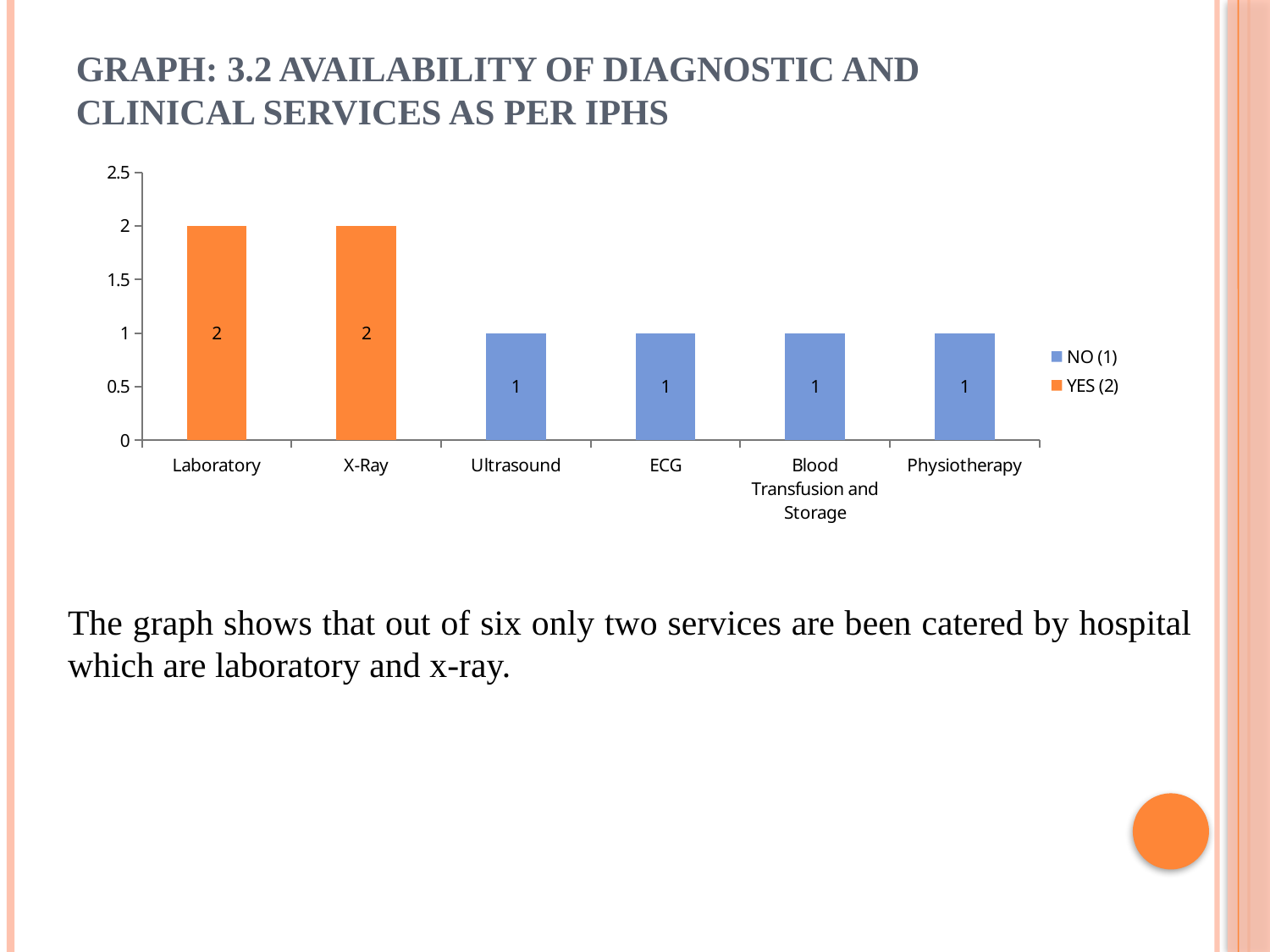
What is the difference between the values for X-Ray and ECG? 1 How many service categories are shown on the x axis? 6 Which legend entry is shown in orange? YES (2) What is the value shown for Physiotherapy? 1 How many series does the legend list? 2 Is the value for X-Ray greater or less than 1.5? greater What kind of chart is shown on the slide? bar chart What is the value shown for Ultrasound? 1 Which services have a value of 2? Laboratory and X-Ray Which is larger, the value for Laboratory or the value for Ultrasound? Laboratory What is the value shown for Laboratory? 2 What is the value shown for Blood Transfusion and Storage? 1